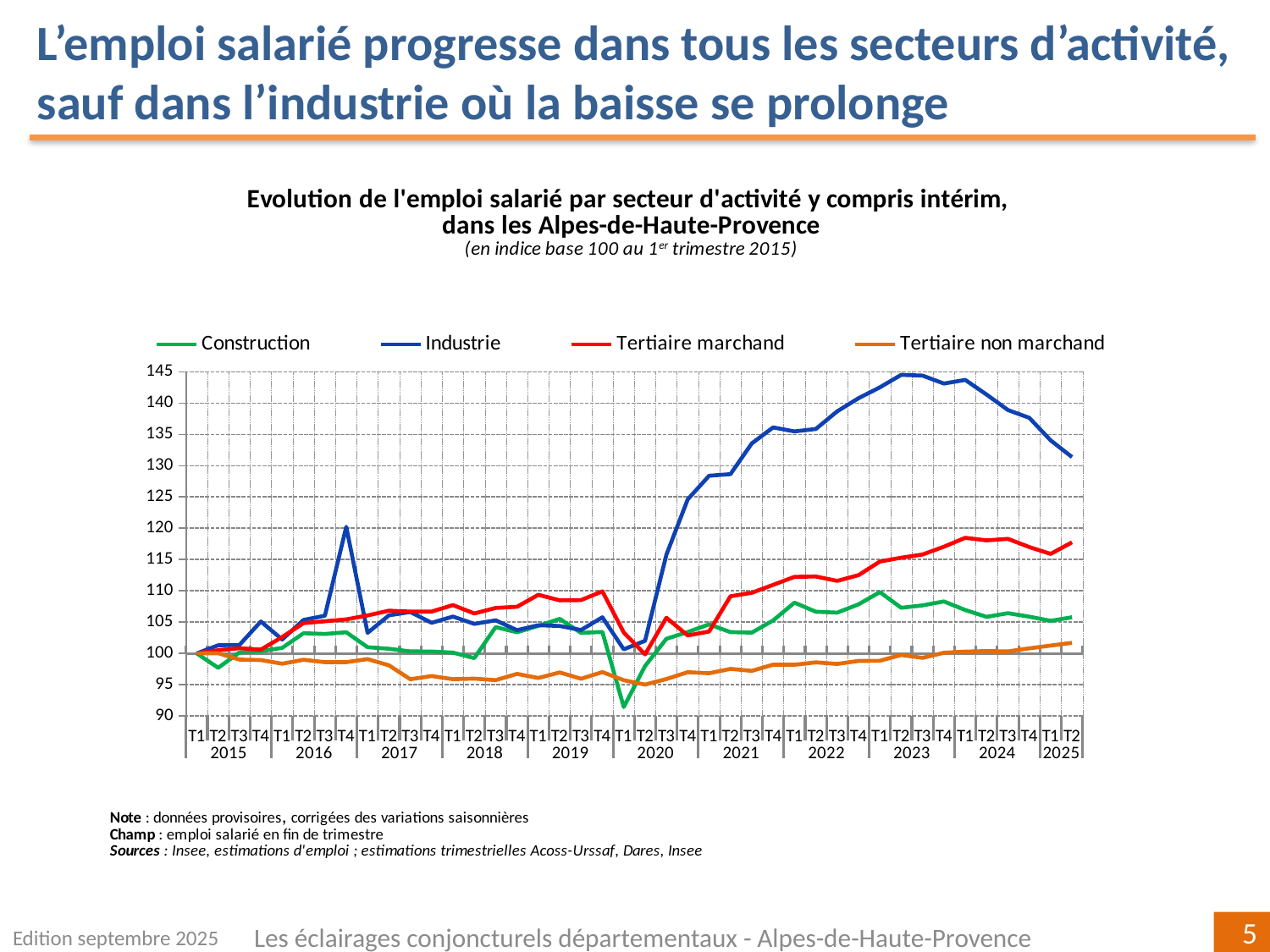
How many years are labelled on the x axis? 11 Is the value for Tertiaire non marchand at T1 2017 greater or less than 100? less What kind of chart is shown on the slide? Line chart At T2 2025, which is larger: Construction or Tertiaire marchand? Tertiaire marchand Does the Industrie series rise or fall between T2 2023 and T2 2025? Fall Which series has the lowest value at T2 2025? Tertiaire non marchand Which series has the highest value at T2 2025? Industrie Is the value for Construction at T1 2020 greater or less than 95? less Is the value for Tertiaire marchand at T2 2025 greater or less than 115? greater What is the base of the index used in the chart? Base 100 au 1er trimestre 2015 How many series does the legend list? 4